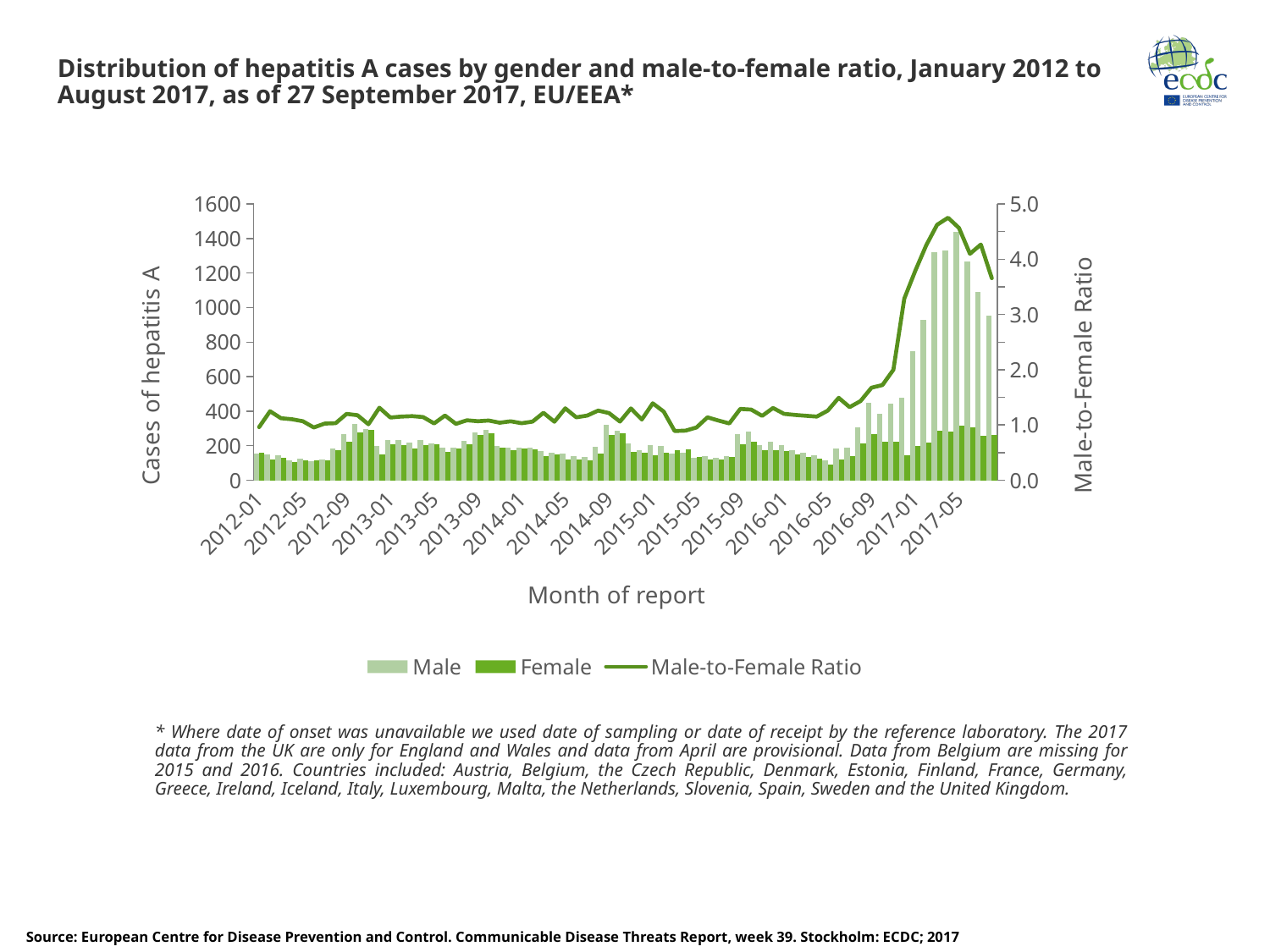
Does the Male-to-Female Ratio rise or fall between 2016-09 and 2017-01? rise Do Male cases rise or fall between 2016-05 and 2017-01? rise Is the Male-to-Female Ratio in 2012-01 greater or less than 2.0? less What is the title of the left vertical axis? Cases of hepatitis A What kind of chart is this? Combined bar and line chart In 2017-05, which is larger, the number of Male cases or the number of Female cases? Male Is the number of Female cases in 2015-05 greater or less than 400? less Is the number of Male cases in 2012-01 greater or less than 400? less Which series is plotted as a line rather than bars? Male-to-Female Ratio How many series does the legend list? 3